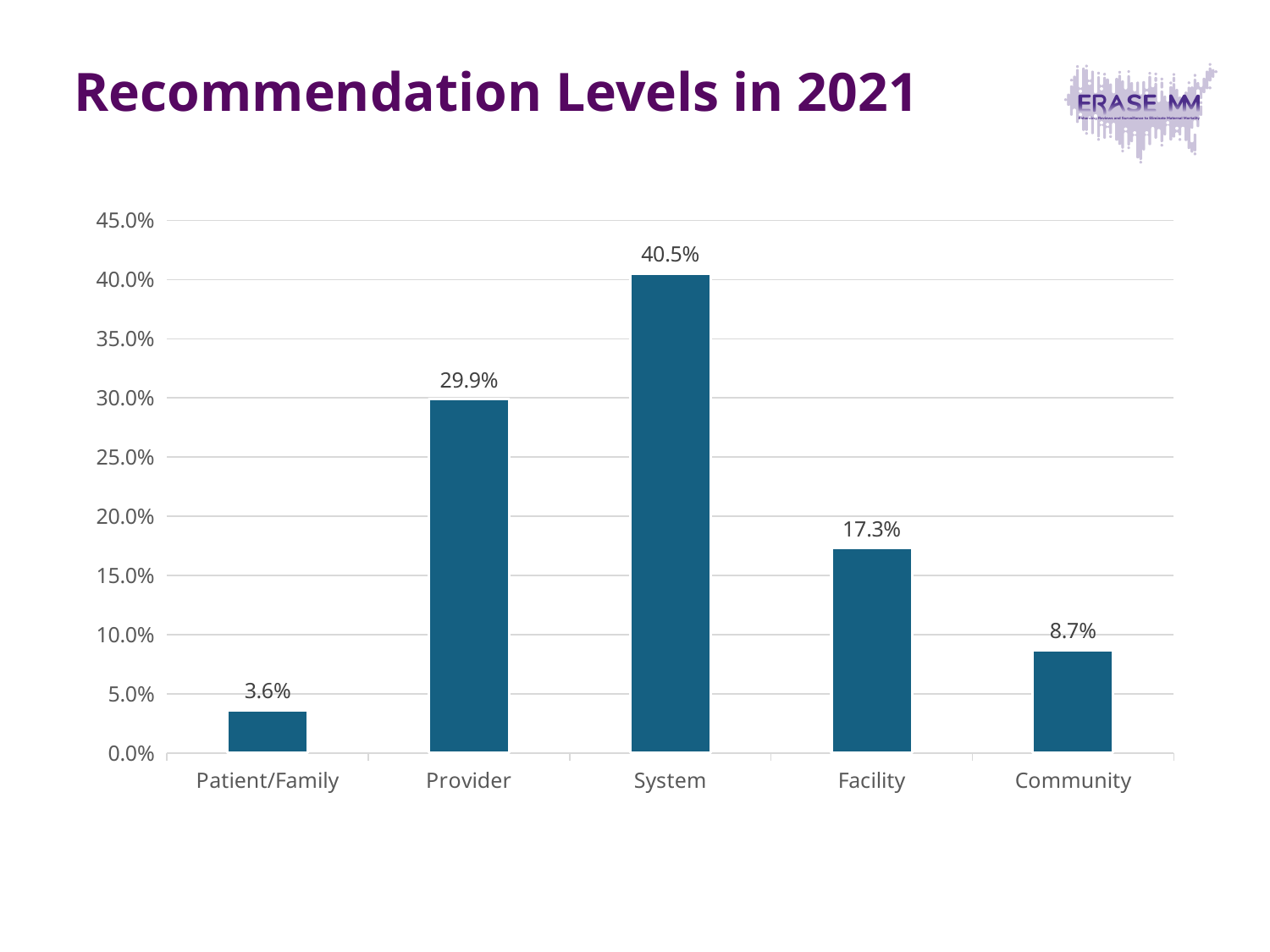
Which category has the highest value? System What is the value for Community? 8.7% Is the value for Facility greater or less than 20.0%? less What is the difference between the values for Facility and Community? 8.6% What kind of chart is shown on the slide? bar chart What is the value for System? 40.5% What is the difference between the values for System and Provider? 10.6% Which is larger, the value for Provider or the value for Facility? Provider How many categories are shown on the x axis? 5 What is the value for Patient/Family? 3.6% What is the title of the slide? Recommendation Levels in 2021 Which category has the lowest value? Patient/Family